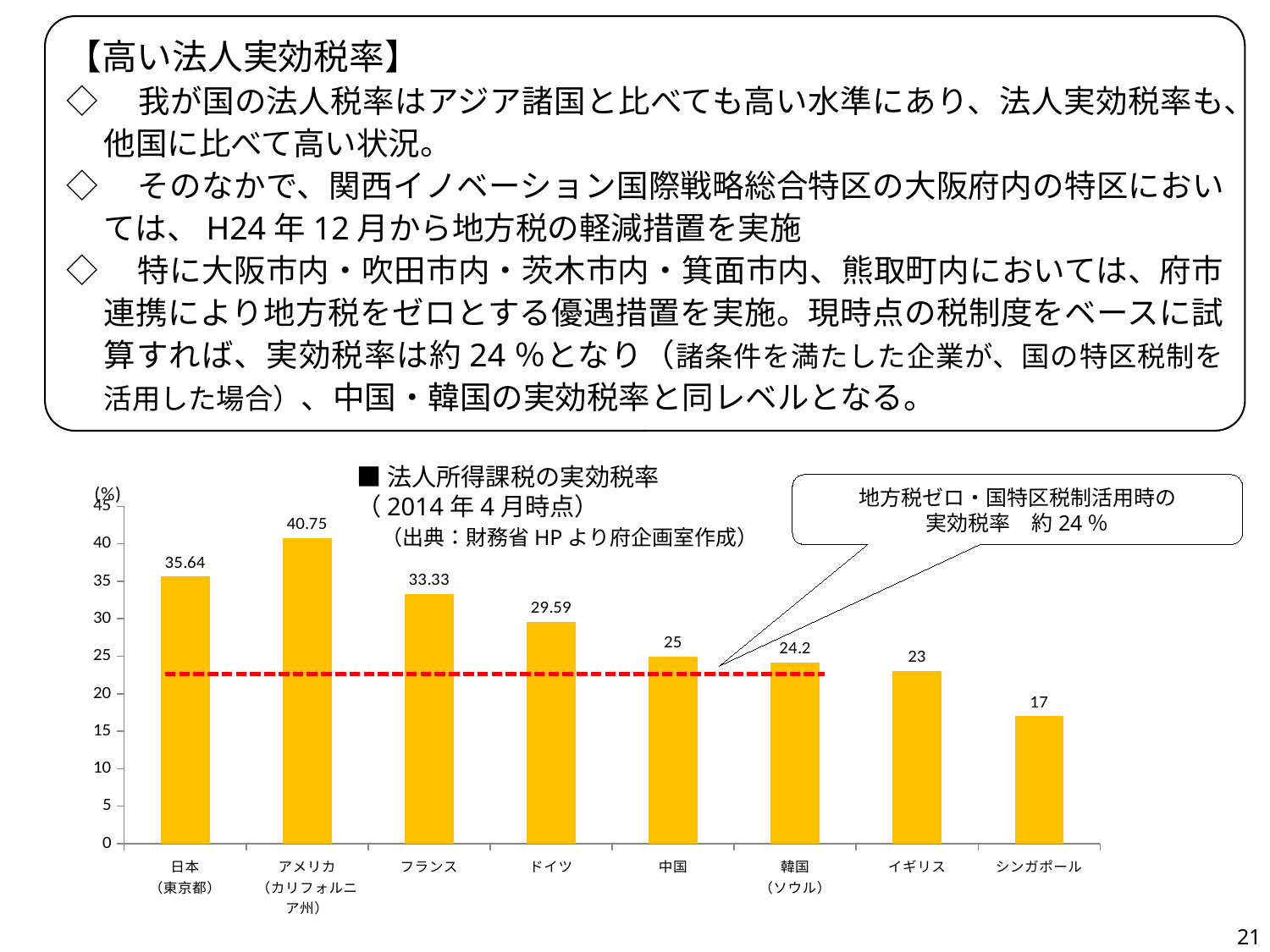
What is the difference between the values for 日本（東京都） and 中国? 10.64 What is the value shown for アメリカ（カリフォルニア州）? 40.75 How many countries/regions are shown in the chart? 8 What is the value shown for フランス? 33.33 What effective tax rate does the callout box say applies when local tax is zero and the national special zone tax system is used? 約24％ Is the value for シンガポール greater or less than 20? less What kind of chart is shown on the slide? bar chart What is the effective corporate tax rate shown for 日本（東京都）? 35.64 Which country has the lowest effective tax rate in the chart? シンガポール Which has a higher value, ドイツ or イギリス? ドイツ Which country has the highest effective tax rate in the chart? アメリカ（カリフォルニア州） What is the value shown for 韓国（ソウル）? 24.2